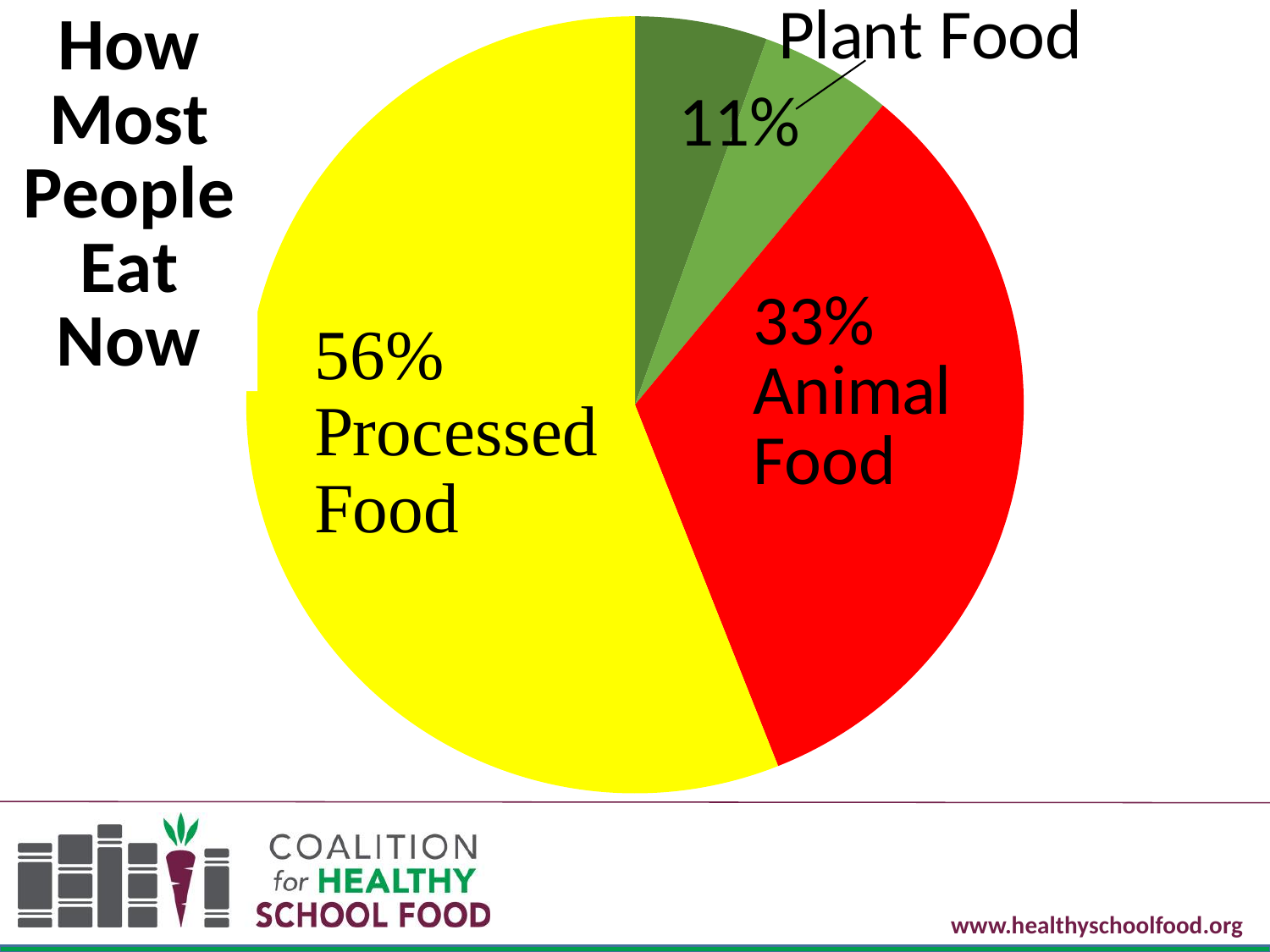
What percentage of the pie is Processed Food? 56% What is the difference in percentage points between Processed Food and Plant Food? 45 How many percentage points larger is Processed Food than Animal Food? 23 What percentage of the pie is Animal Food? 33% How many percentage points larger is Animal Food than Plant Food? 22 What is the title of the chart? How Most People Eat Now Which is larger, the share for Animal Food or the share for Plant Food? Animal Food What percentage of the pie is Plant Food? 11% Which category has the largest share of the pie? Processed Food What colour is the Animal Food slice? Red Which category has the smallest share of the pie? Plant Food What kind of chart is shown on the slide? Pie chart